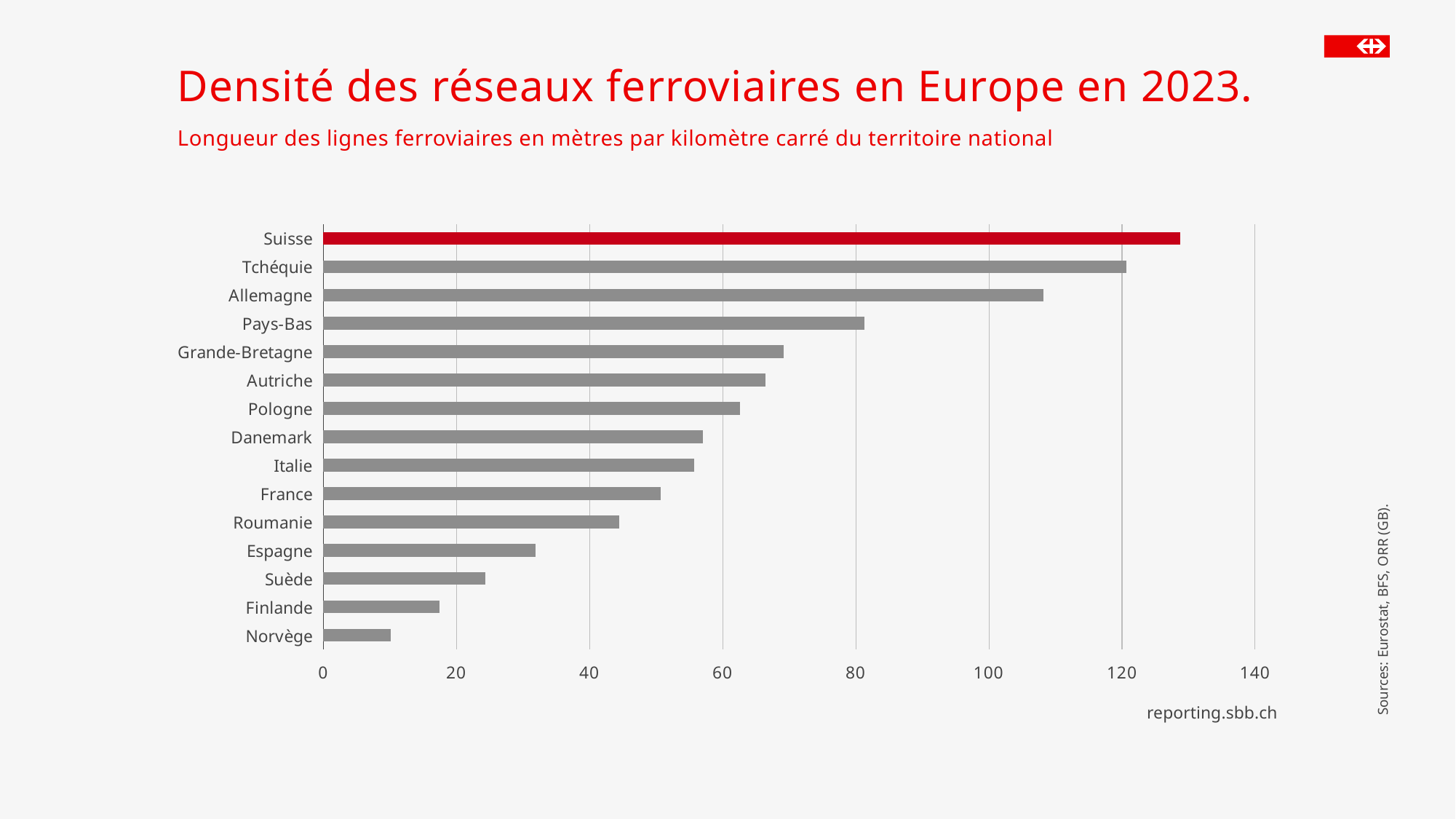
Is the value for Suisse greater or less than 120? greater How many countries are shown in the chart? 15 Which country has the highest rail network density in the chart? Suisse Is the value for Espagne greater or less than 40? less Which has a higher value, Espagne or Suède? Espagne Which has a higher value, Allemagne or Pays-Bas? Allemagne Is the value for Pays-Bas greater or less than 100? less Which country's bar is highlighted in red? Suisse Which country has the lowest rail network density in the chart? Norvège What kind of chart is shown on the slide? bar chart